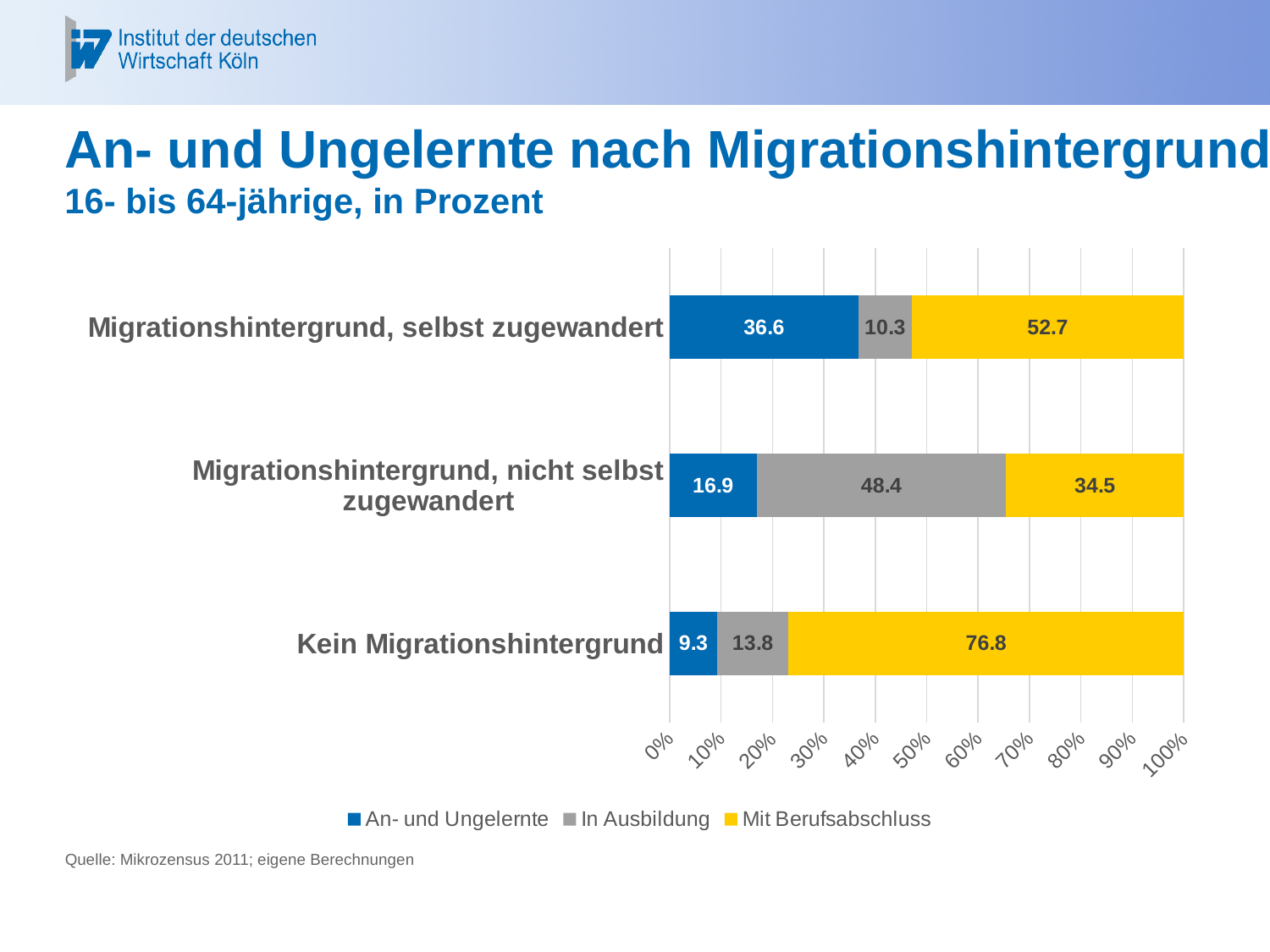
Which series is shown in yellow in the legend? Mit Berufsabschluss What is the value for "Mit Berufsabschluss" in the "Kein Migrationshintergrund" category? 76.8 What kind of chart is shown on the slide? Stacked bar chart Which category has the highest value for "An- und Ungelernte"? Migrationshintergrund, selbst zugewandert How many series does the legend list? 3 What is the value for "In Ausbildung" in the "Migrationshintergrund, nicht selbst zugewandert" category? 48.4 Which is larger: the "In Ausbildung" value for "Migrationshintergrund, nicht selbst zugewandert" or for "Kein Migrationshintergrund"? Migrationshintergrund, nicht selbst zugewandert What is the total of the stacked bar for "Kein Migrationshintergrund"? 99.9 How many categories are shown on the chart? 3 What is the difference between the "Mit Berufsabschluss" values for "Kein Migrationshintergrund" and "Migrationshintergrund, selbst zugewandert"? 24.1 Which category has the lowest value for "Mit Berufsabschluss"? Migrationshintergrund, nicht selbst zugewandert What is the value for "An- und Ungelernte" in the "Migrationshintergrund, selbst zugewandert" category? 36.6